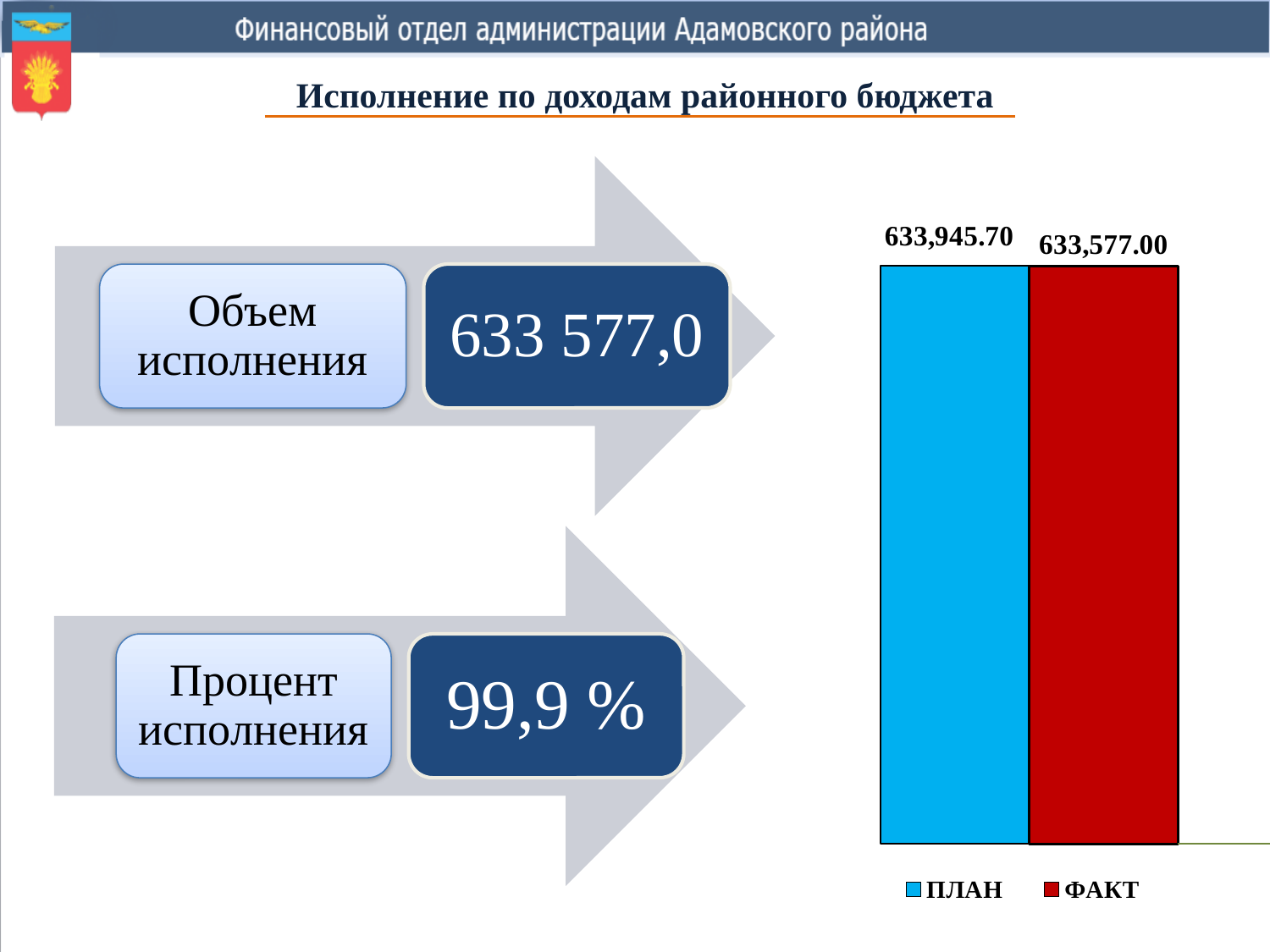
What colour is the ПЛАН bar in the chart? blue How many bars are plotted in the chart? 2 How many series does the chart legend list? 2 According to the data labels, which series has the larger value, ПЛАН or ФАКТ? ПЛАН What kind of chart is shown on the slide? bar chart What colour is the ФАКТ bar in the chart? red What is the difference between the ПЛАН and ФАКТ values shown in the chart? 368.70 What is the value of the ПЛАН bar in the chart? 633,945.70 Which series in the chart has the lowest value? ФАКТ What is the value of the ФАКТ bar in the chart? 633,577.00